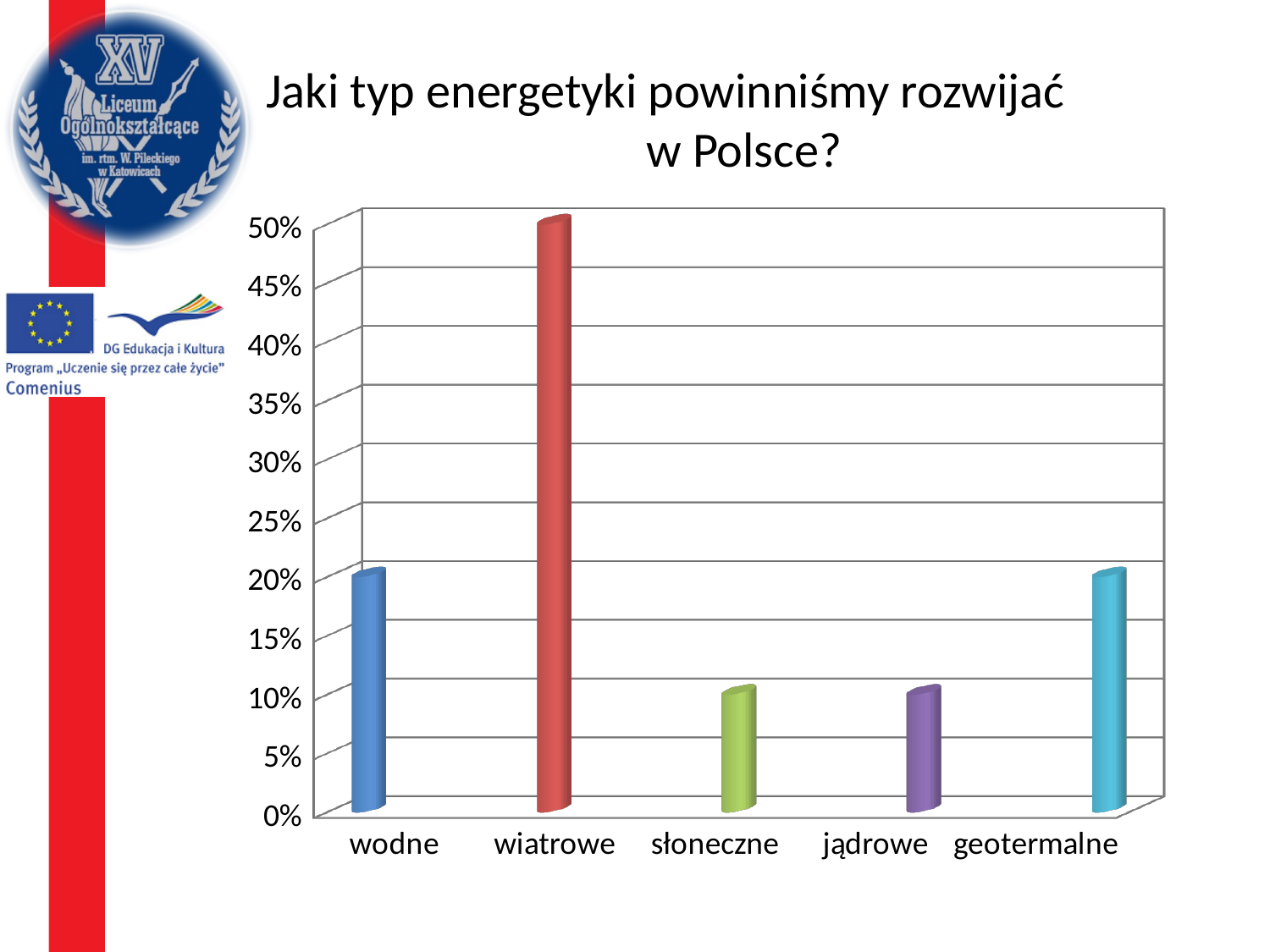
What type of chart is shown on the slide? bar chart Which category has the highest value in the chart? wiatrowe What is the value for słoneczne? 10% What is the title of the chart on the slide? Jaki typ energetyki powinniśmy rozwijać w Polsce? How many categories are shown on the x axis of the chart? 5 What is the value for geotermalne? 20% What is the value for wiatrowe? 50% Is the value for wiatrowe greater or less than 40%? greater Is the value for jądrowe greater or less than 15%? less What is the difference between the values for wiatrowe and wodne? 30% What is the value for wodne? 20% Which is larger, the value for wiatrowe or the value for wodne? wiatrowe